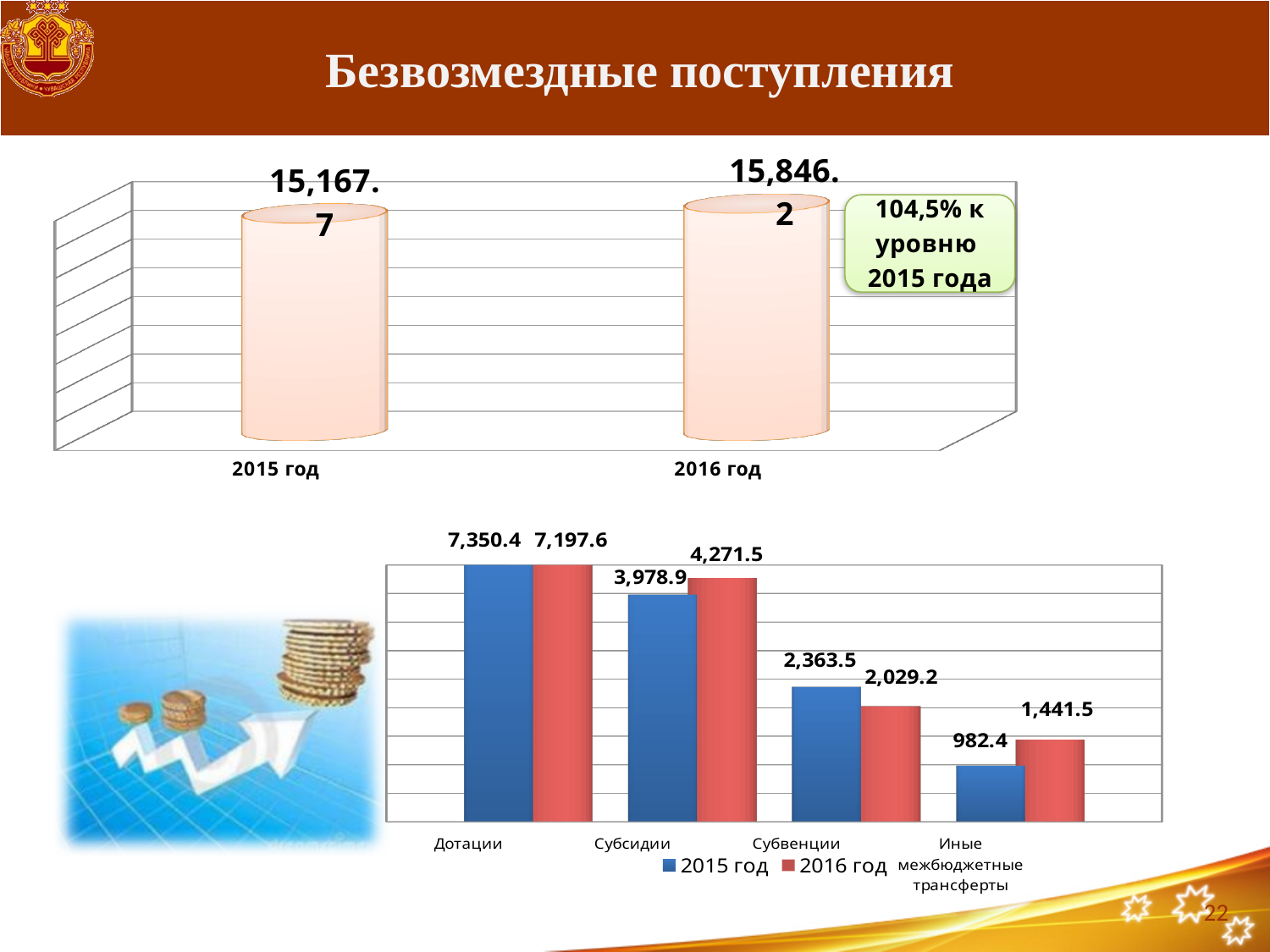
In the bottom chart, what is the 2016 год value for Субсидии? 4,271.5 In the bottom chart, what is the 2015 год value for Дотации? 7,350.4 In the bottom chart, what is the difference between the 2015 год and 2016 год values for Субвенции? 334.3 In the bottom chart, which category has the lowest 2015 год value? Иные межбюджетные трансферты In the top chart, what percentage of the 2015 level does the callout say 2016 reached? 104,5% In the top chart, what is the value for 2015 год? 15,167.7 In the bottom chart, what is the 2016 год value for Иные межбюджетные трансферты? 1,441.5 How many series does the legend of the bottom chart list? 2 In the top chart, what is the difference between the 2016 год and 2015 год values? 678.5 In the bottom chart, which is larger for Субсидии: the 2015 год value or the 2016 год value? 2016 год In the bottom chart, which category has the highest 2016 год value? Дотации In the top chart, what is the value for 2016 год? 15,846.2